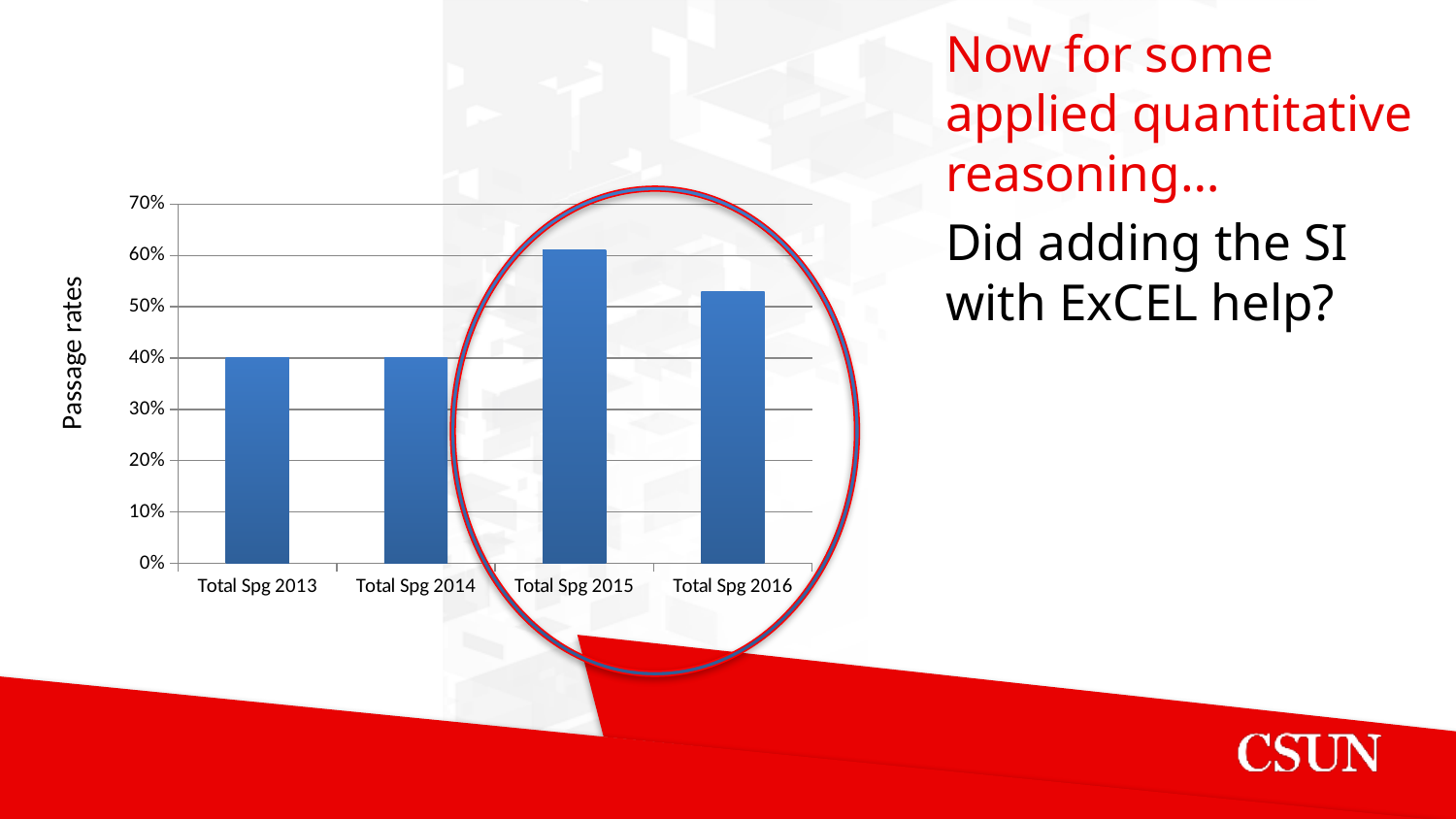
Is the value for Total Spg 2016 greater or less than 50%? greater Which is larger, the passage rate for Total Spg 2015 or Total Spg 2016? Total Spg 2015 What kind of chart is shown on the slide? bar chart Does the passage rate rise or fall from Total Spg 2015 to Total Spg 2016? fall What is the passage rate for Total Spg 2013? 40% Which category has the highest passage rate? Total Spg 2015 What is the label on the vertical axis of the chart? Passage rates How many categories are plotted on the chart? 4 Does the passage rate rise or fall from Total Spg 2014 to Total Spg 2015? rise Is the value for Total Spg 2016 greater or less than 60%? less What is the passage rate for Total Spg 2014? 40%